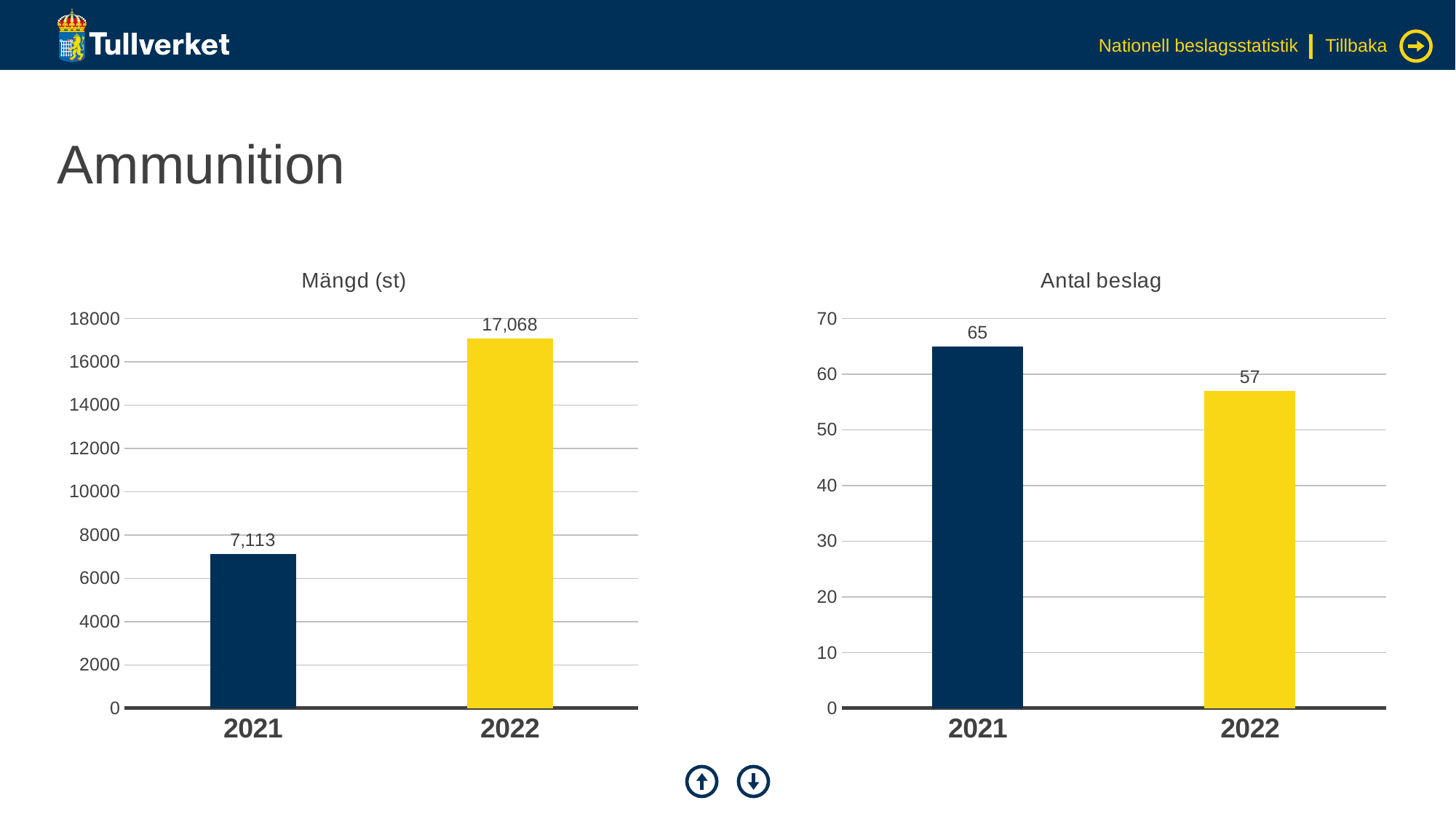
How many categories are shown on the x axis of the 'Antal beslag' chart? 2 In the 'Mängd (st)' chart, what is the difference between the 2022 and 2021 values? 9,955 In the 'Antal beslag' chart, what is the value for 2022? 57 In the 'Antal beslag' chart, what is the difference between the 2021 and 2022 values? 8 What kind of chart is the 'Mängd (st)' chart? bar chart In the 'Mängd (st)' chart, which year has the highest value? 2022 In the 'Mängd (st)' chart, what is the value for 2021? 7,113 In the 'Antal beslag' chart, what is the value for 2021? 65 In the 'Antal beslag' chart, which year has the lowest value? 2022 In the 'Mängd (st)' chart, is the value for 2021 greater or less than 8000? less In the 'Antal beslag' chart, which is larger, the value for 2021 or 2022? 2021 In the 'Mängd (st)' chart, what is the value for 2022? 17,068